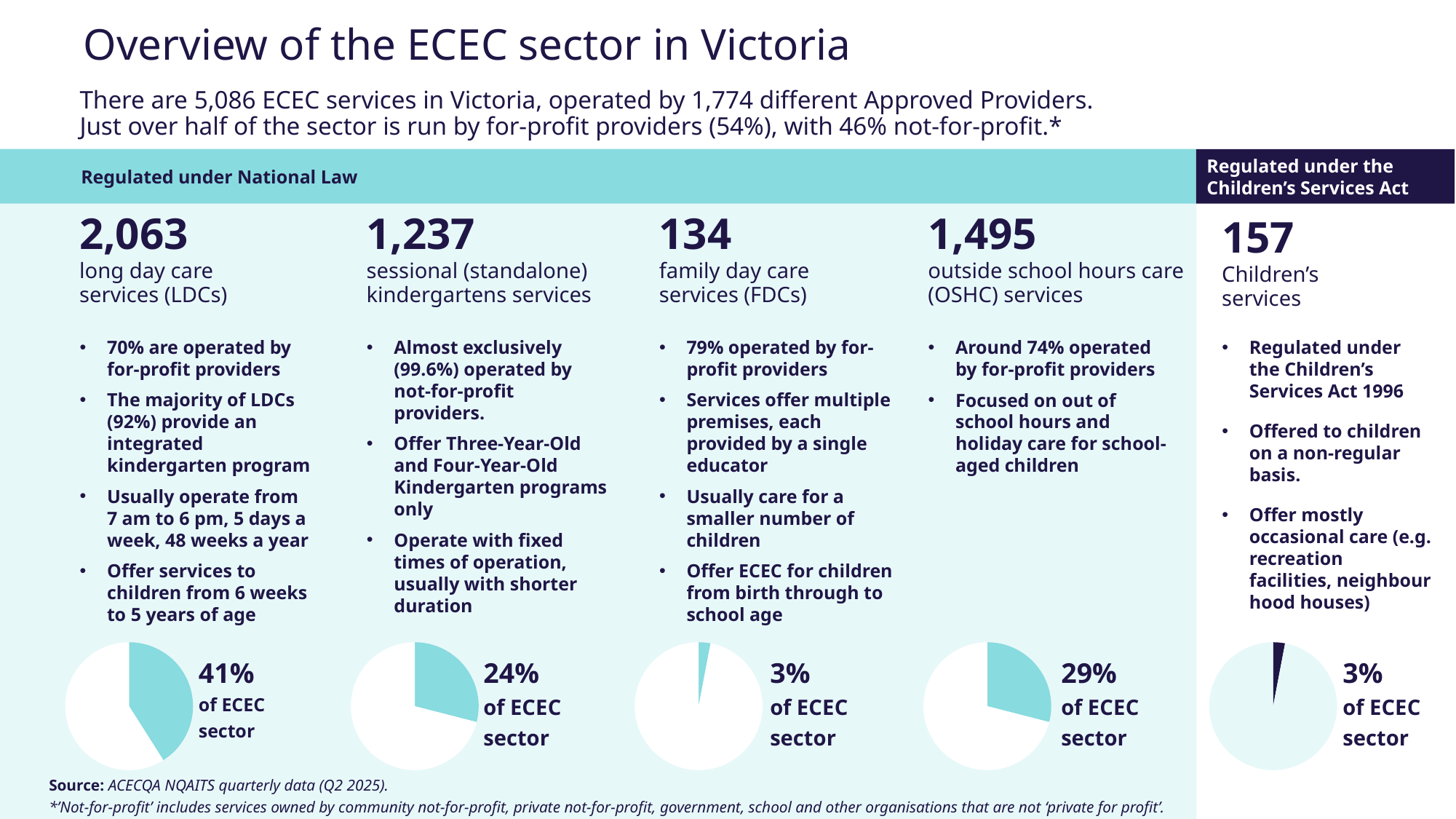
What share of the ECEC sector do sessional (standalone) kindergarten services represent, according to their pie chart? 24% Which has the larger share of the ECEC sector: sessional (standalone) kindergartens or outside school hours care (OSHC) services? outside school hours care (OSHC) services Which service type has the largest share of the ECEC sector across the pie charts on the slide? long day care services (LDCs) What share of the ECEC sector do Children's services (regulated under the Children's Services Act) represent, according to their pie chart? 3% What share of the ECEC sector do outside school hours care (OSHC) services represent, according to their pie chart? 29% What is the difference in percentage points between the long day care share (41%) and the OSHC share (29%) of the ECEC sector? 12 percentage points What type of chart is used to show each service type's share of the ECEC sector? pie chart How many outside school hours care (OSHC) services are there in Victoria, according to the figure above the OSHC pie chart? 1,495 How many pie charts are shown on the slide? 5 What colour is the highlighted slice in the pie chart for Children's services under the Children's Services Act? dark navy